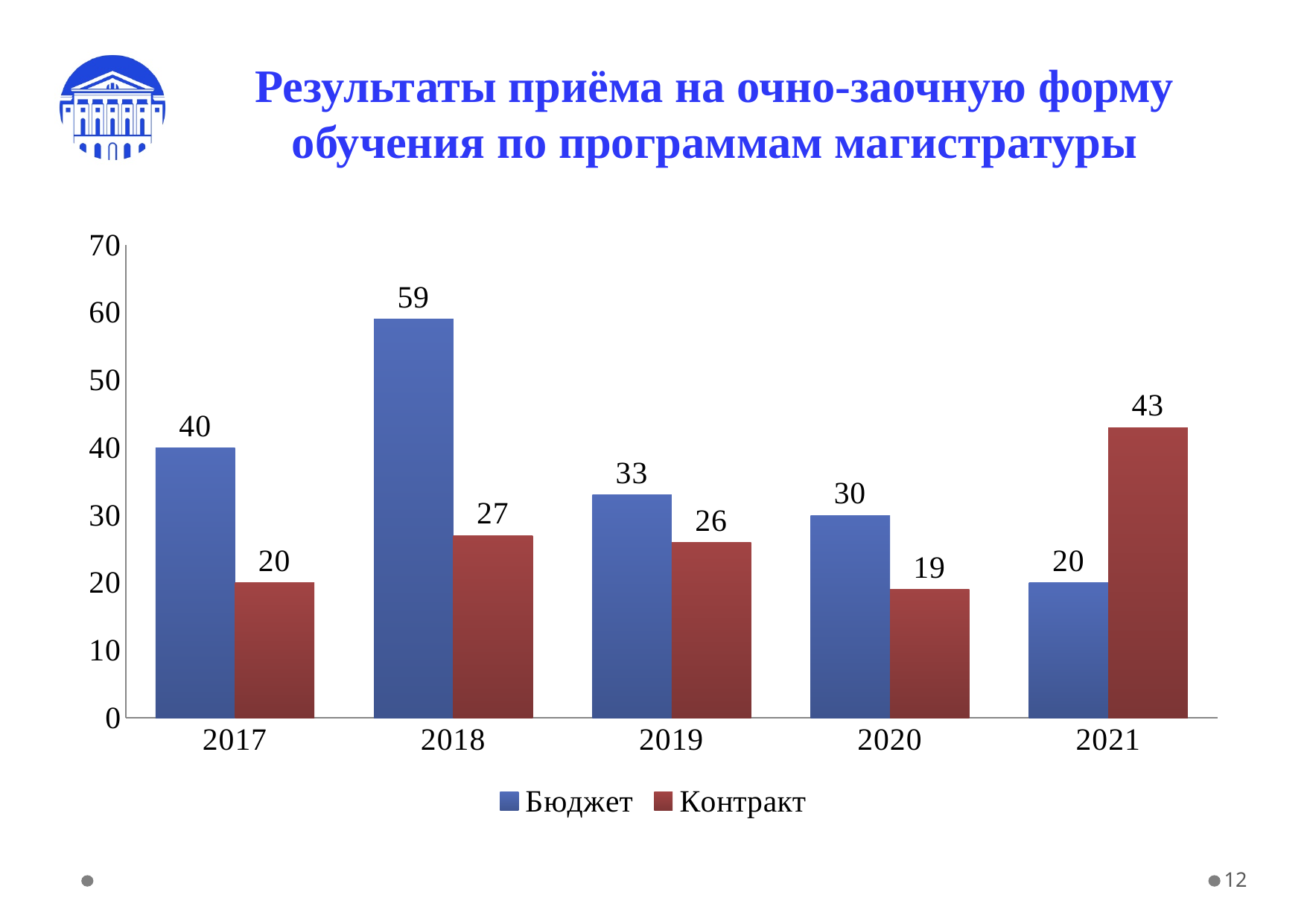
In which year is the Контракт value lowest? 2020 What is the value for Бюджет in 2018? 59 How many years are shown on the x axis? 5 What is the difference between the Бюджет and Контракт values in 2018? 32 How many series does the legend list? 2 In which year is the Бюджет value highest? 2018 Does the Бюджет value rise or fall from 2018 to 2021? fall What is the value for Контракт in 2020? 19 Which is larger in 2021, Бюджет or Контракт? Контракт What is the value for Контракт in 2021? 43 Is the value for Бюджет in 2019 greater or less than 30? greater What kind of chart is shown on the slide? bar chart